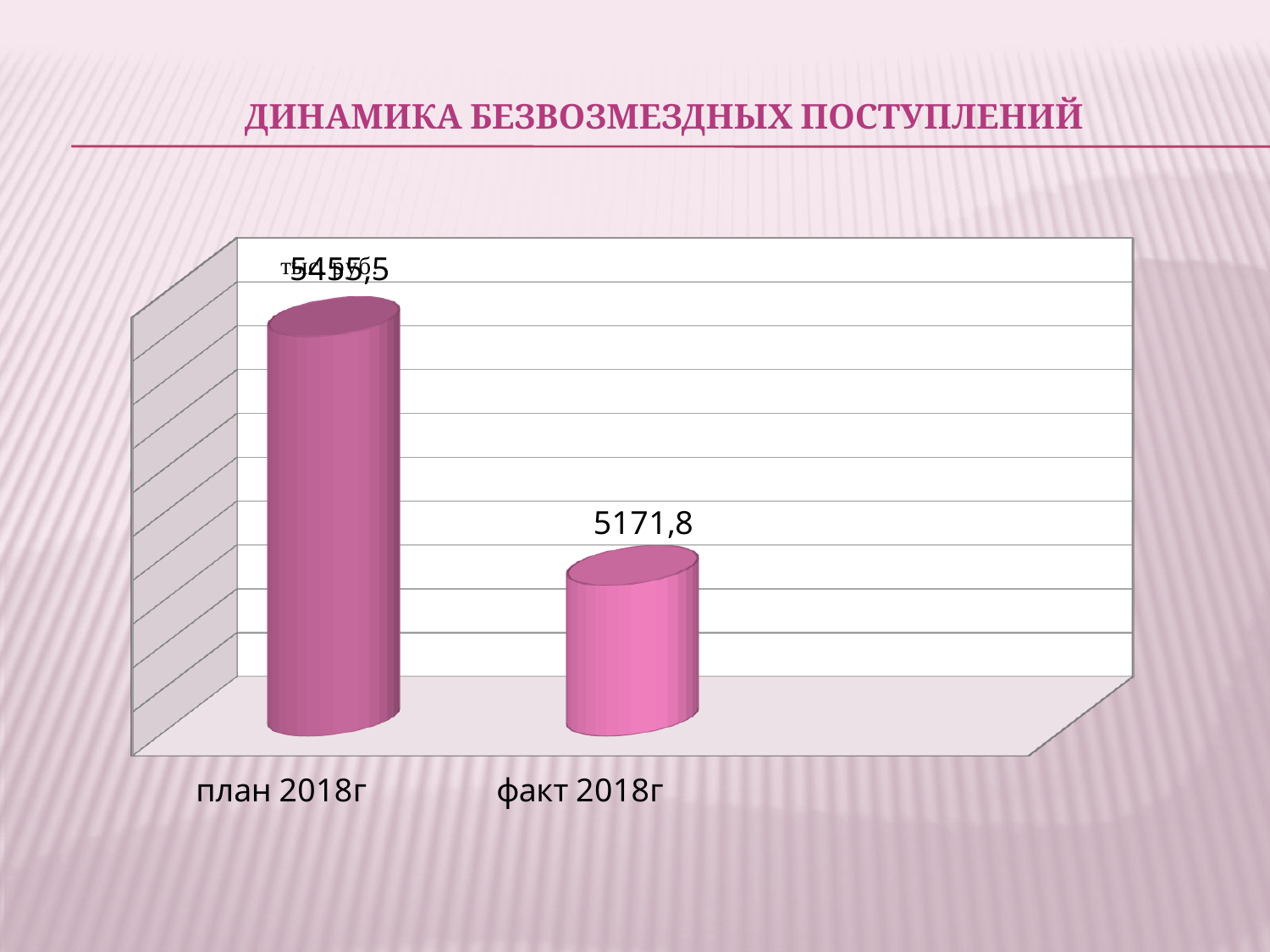
Which category has the lowest value? факт 2018г What is the title of the slide? Динамика безвозмездных поступлений What is the label of the second bar on the chart? факт 2018г Which is larger, the value for план 2018г or the value for факт 2018г? план 2018г Which category has the highest value? план 2018г What kind of chart is shown on the slide? bar chart Do the values rise or fall from план 2018г to факт 2018г? fall What is the value for факт 2018г? 5171,8 How many categories are shown on the chart? 2